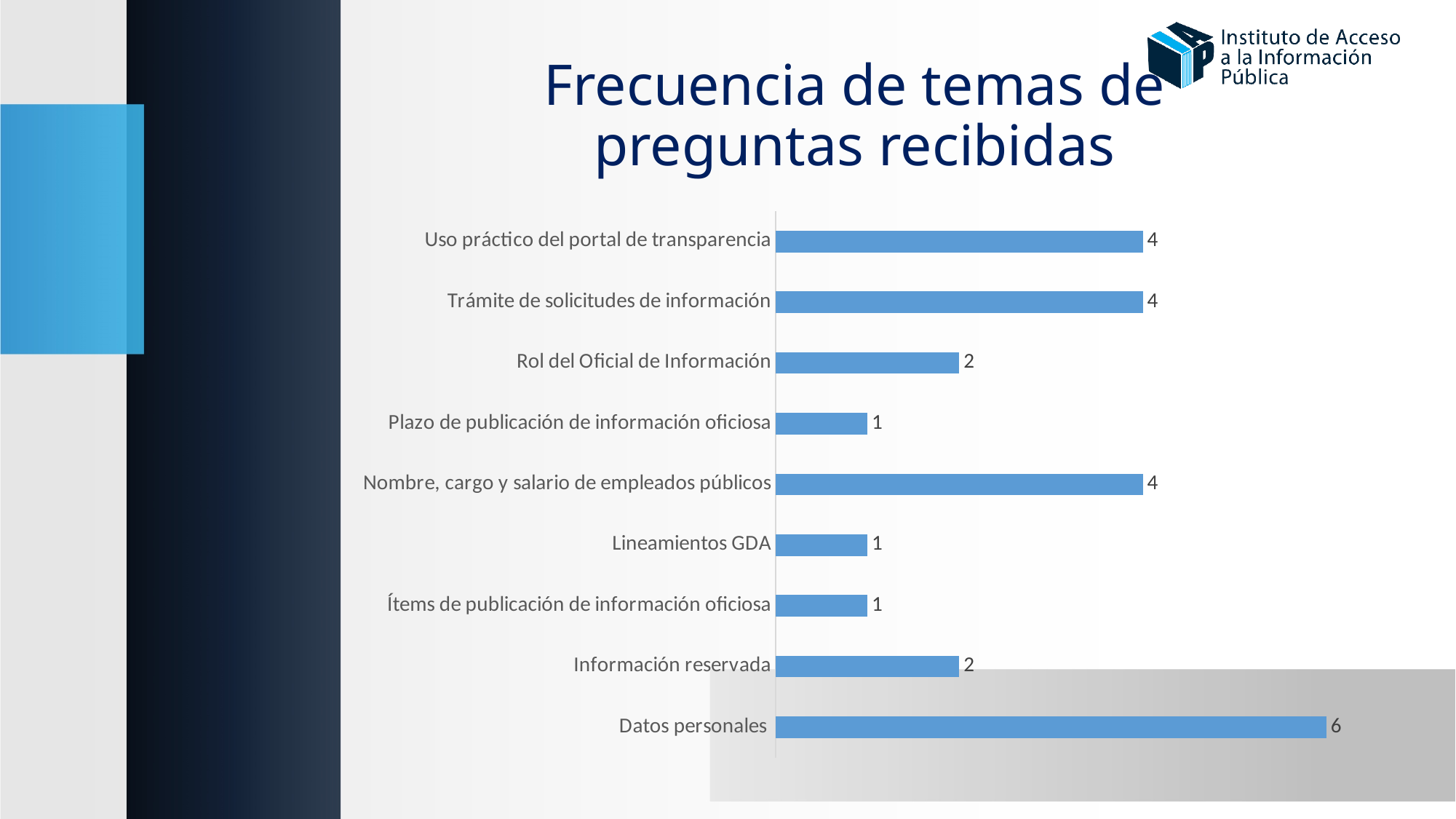
What kind of chart is shown on the slide? Bar chart What is the difference between the values for Datos personales and Información reservada? 4 Which is larger, the value for Nombre, cargo y salario de empleados públicos or the value for Información reservada? Nombre, cargo y salario de empleados públicos Which category has the highest value? Datos personales What is the value for Rol del Oficial de Información? 2 How many categories are shown in the chart? 9 What is the value for Datos personales? 6 What is the title of the slide? Frecuencia de temas de preguntas recibidas What is the value for Trámite de solicitudes de información? 4 What is the value for Lineamientos GDA? 1 What is the difference between the values for Uso práctico del portal de transparencia and Plazo de publicación de información oficiosa? 3 How many categories have a value of 4? 3